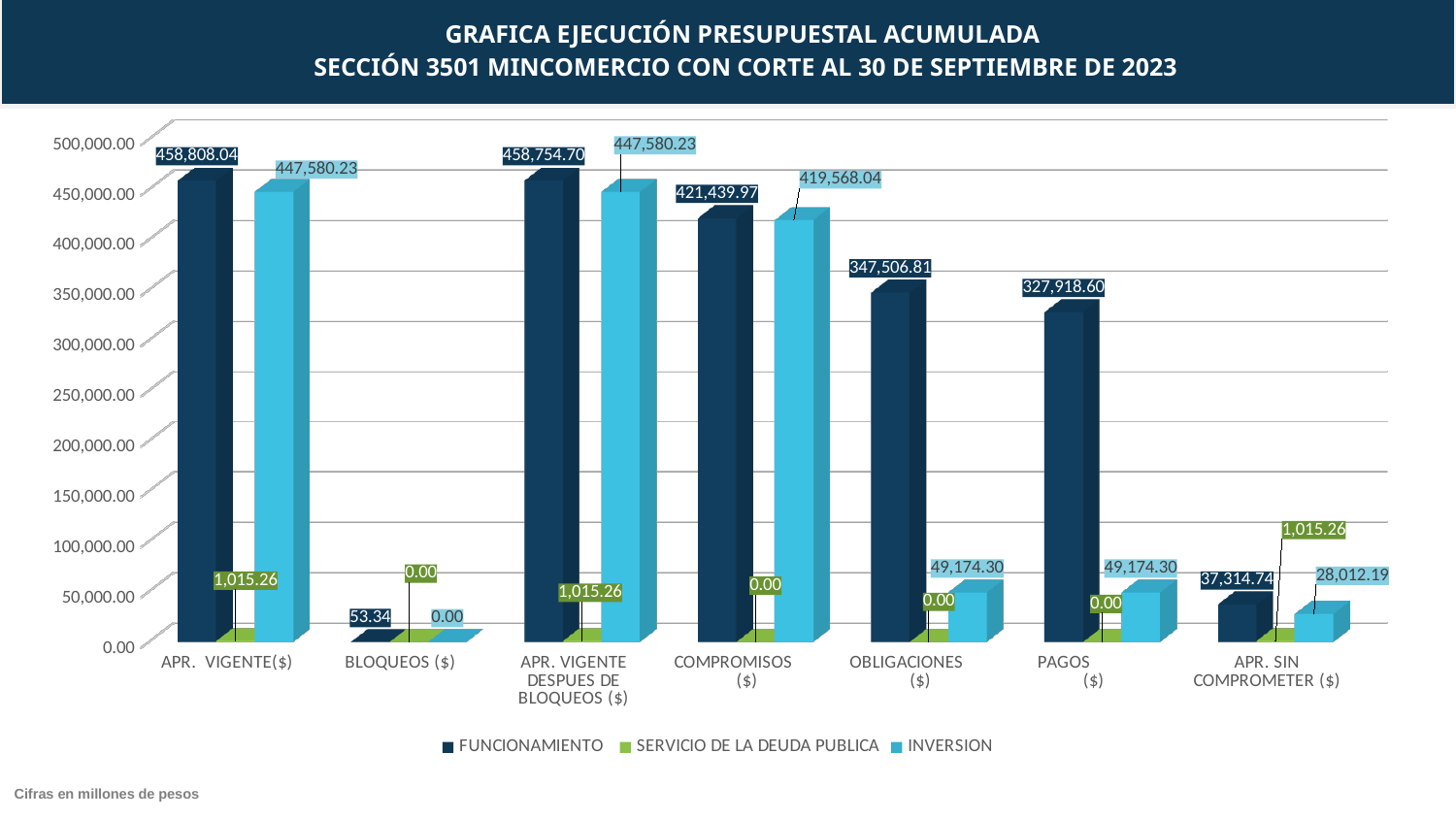
What is the difference between the FUNCIONAMIENTO values for OBLIGACIONES ($) and PAGOS ($)? 19,588.21 What is the FUNCIONAMIENTO value for BLOQUEOS ($)? 53.34 What kind of chart is shown on the slide? Bar chart Which category has the lowest FUNCIONAMIENTO value? BLOQUEOS ($) Which is larger for COMPROMISOS ($): the FUNCIONAMIENTO value or the INVERSION value? FUNCIONAMIENTO What is the INVERSION value for OBLIGACIONES ($)? 49,174.30 What is the FUNCIONAMIENTO value for COMPROMISOS ($)? 421,439.97 Is the FUNCIONAMIENTO value for PAGOS ($) greater or less than 300,000.00? greater How many series does the legend list? 3 What is the SERVICIO DE LA DEUDA PUBLICA value for APR. SIN COMPROMETER ($)? 1,015.26 Which category has the highest FUNCIONAMIENTO value? APR. VIGENTE($) How many categories are shown on the x axis? 7